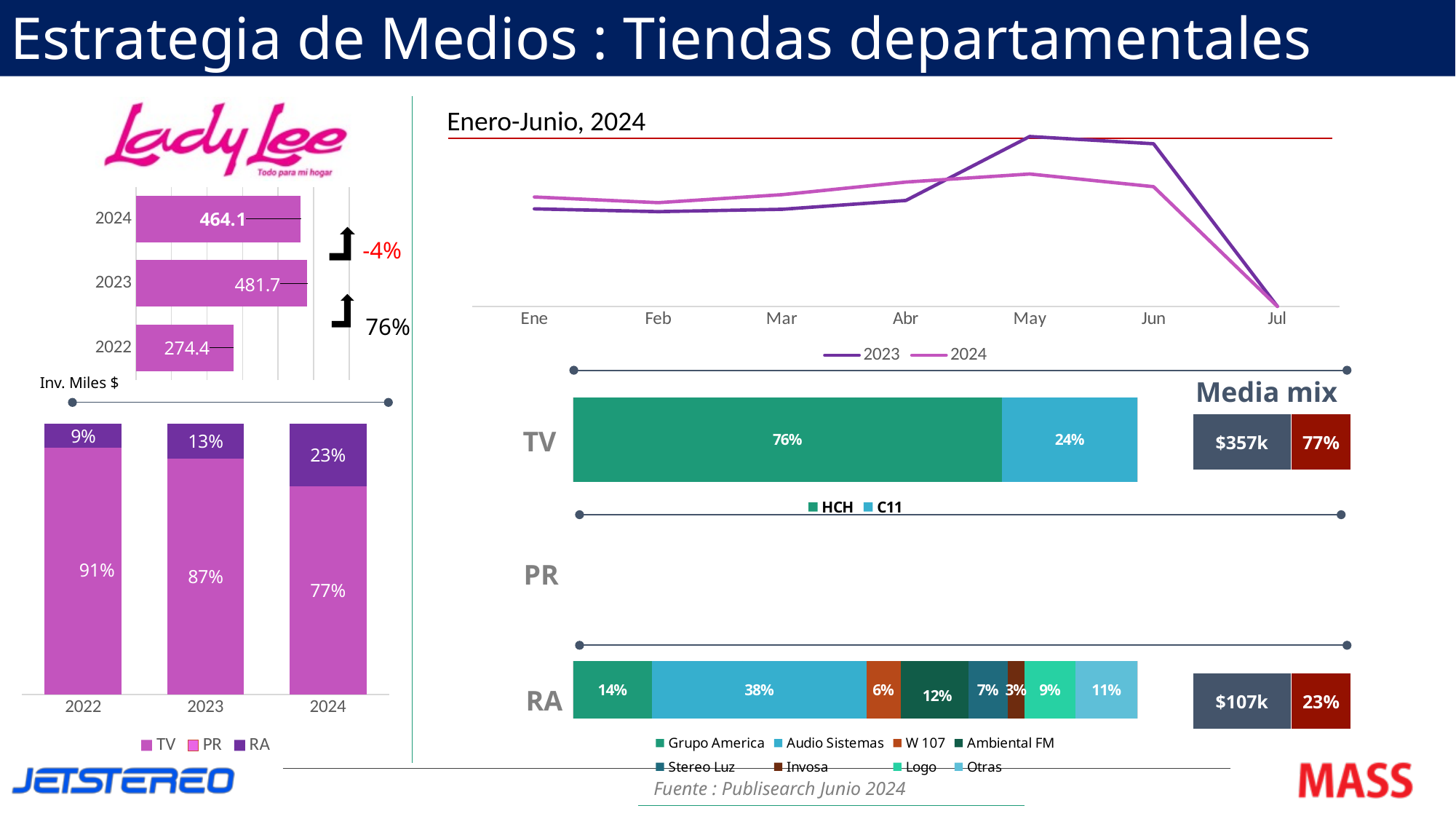
In the stacked bar chart by year at the bottom left, what is the RA share for 2024? 23% In the RA stacked bar, which station has the largest share? Audio Sistemas In the horizontal bar chart of investment by year (Inv. Miles $), what is the value for 2023? 481.7 In the horizontal bar chart of investment by year (Inv. Miles $), what is the difference between the 2023 and 2024 values? 17.6 What kind of chart is the Enero-Junio, 2024 chart at the top right? line chart In the stacked bar chart by year at the bottom left, how many series does the legend list? 3 In the horizontal bar chart of investment by year (Inv. Miles $), which year has the highest value? 2023 In the stacked bar chart by year at the bottom left, what is the TV share for 2023? 87% In the TV stacked bar, what is the share for HCH? 76% In the stacked bar chart by year at the bottom left, does the TV share rise or fall from 2022 to 2024? fall In the horizontal bar chart of investment by year (Inv. Miles $), what is the value for 2022? 274.4 In the Enero-Junio, 2024 line chart, how many months are shown on the x axis? 7